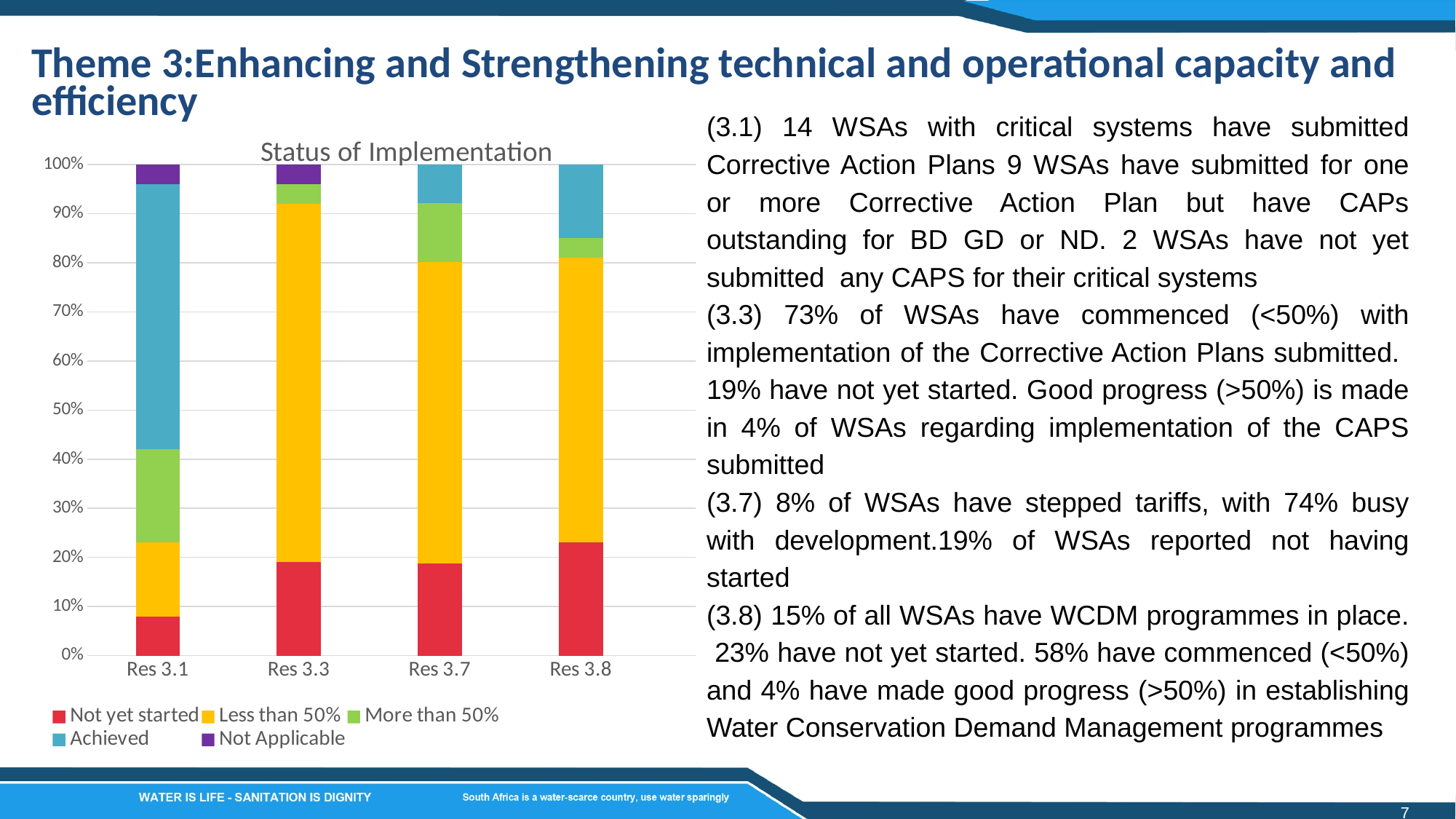
What is the total height of the stacked bar for Res 3.7? 100% Which is larger: the 'More than 50%' segment for Res 3.1 or for Res 3.3? Res 3.1 What is the title of the chart? Status of Implementation Is the 'Achieved' value for Res 3.1 greater or less than 50%? greater Which category has the smallest 'Not yet started' segment? Res 3.1 Which category has the largest 'Achieved' segment? Res 3.1 What kind of chart is shown on the slide? Stacked bar chart Is the 'Not yet started' value for Res 3.8 greater or less than 20%? greater Is the 'Not yet started' value for Res 3.1 greater or less than 10%? less How many categories are shown on the x axis of the chart? 4 Which category has the largest 'Less than 50%' segment? Res 3.3 How many series does the chart legend list? 5